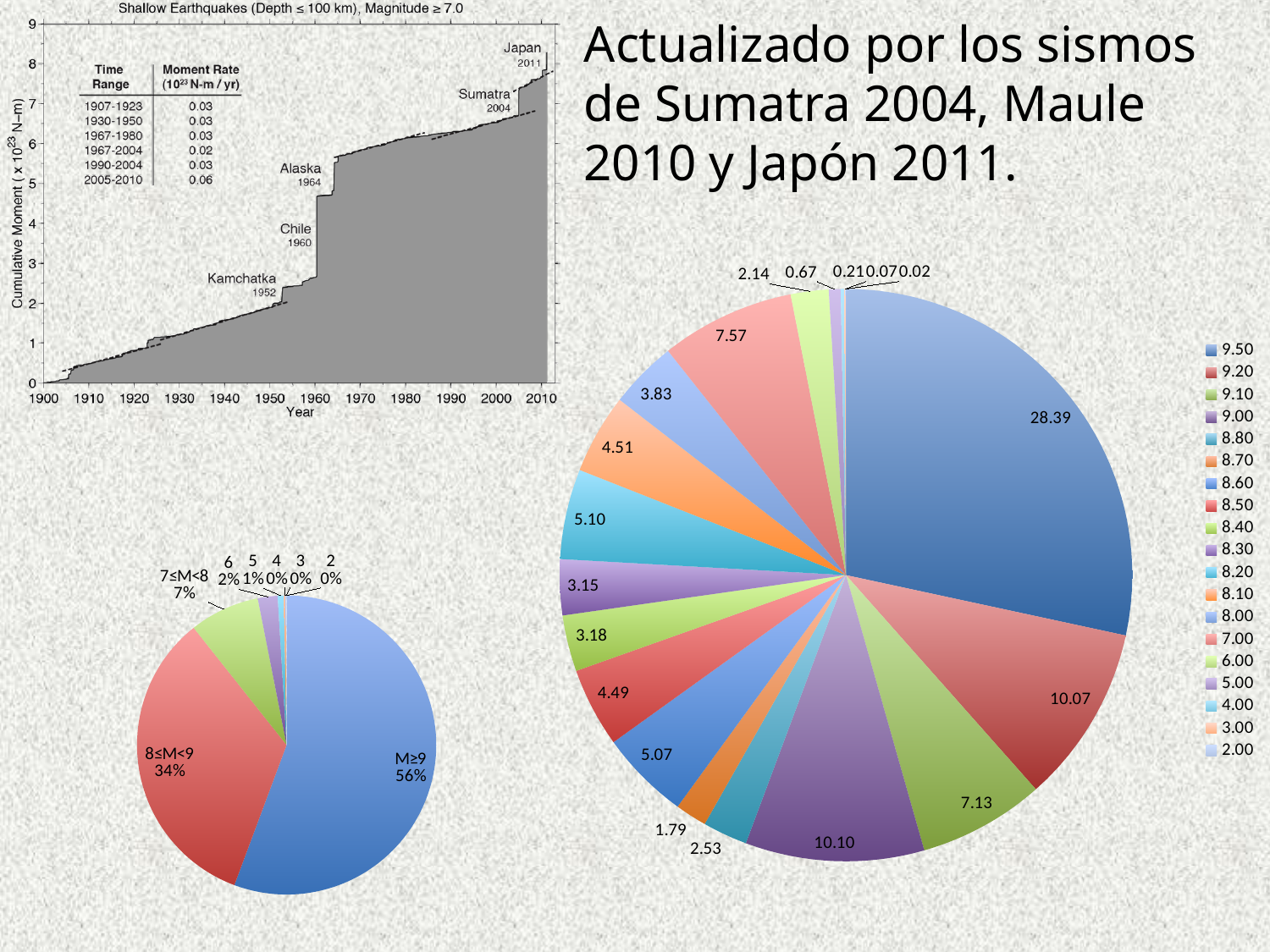
In the large pie chart on the right, what is the value of the largest slice? 28.39 In the large pie chart on the right, what is the value of the smallest labelled slice? 0.02 In the small pie chart at the bottom left, what share is shown for the M≥9 slice? 56% In the large pie chart on the right, which legend entry corresponds to the largest slice (28.39)? 9.50 In the large pie chart on the right, which is larger: the slice labelled 10.10 or the slice labelled 7.13? 10.10 In the top-left chart, which earthquake is labelled at the year 1964? Alaska In the small pie chart at the bottom left, what share is shown for the 8≤M<9 slice? 34% What kind of chart is the large chart on the right of the slide? Pie chart In the small pie chart at the bottom left, which category has the largest slice? M≥9 How many categories are labelled in the small pie chart at the bottom left? 8 How many entries does the legend of the large pie chart on the right list? 19 In the small pie chart at the bottom left, what is the difference between the M≥9 share and the 8≤M<9 share? 22%